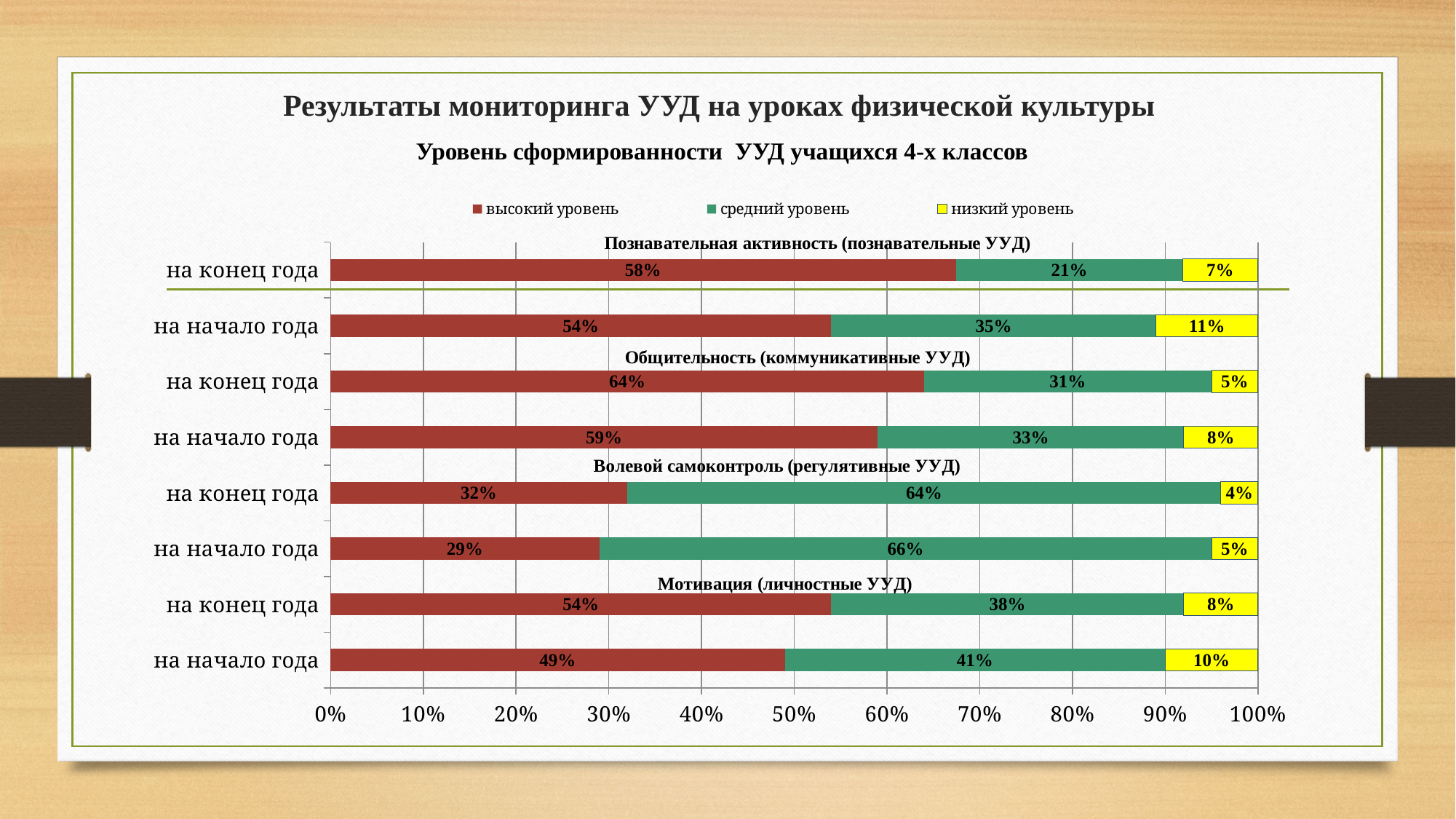
In the 'Мотивация (личностные УУД)' section, what is the difference in 'высокий уровень' between 'на конец года' and 'на начало года'? 5% What kind of chart is shown on the slide? stacked bar chart How many bars are plotted in the chart? 8 What is the value of 'средний уровень' for 'на начало года' in the 'Волевой самоконтроль (регулятивные УУД)' section? 66% Which bar has the lowest 'высокий уровень' value? на начало года (Волевой самоконтроль (регулятивные УУД)) What colour represents 'низкий уровень' in the chart? yellow How many series does the legend list? 3 What is the value of 'низкий уровень' for 'на начало года' in the 'Мотивация (личностные УУД)' section? 10% In the 'Познавательная активность (познавательные УУД)' section, is the 'низкий уровень' value larger for 'на начало года' or 'на конец года'? на начало года What is the value of 'высокий уровень' for 'на конец года' in the 'Общительность (коммуникативные УУД)' section? 64% What is the total of the stacked bar for 'на начало года' in the 'Общительность (коммуникативные УУД)' section? 100% Which bar has the highest 'высокий уровень' value? на конец года (Общительность (коммуникативные УУД))